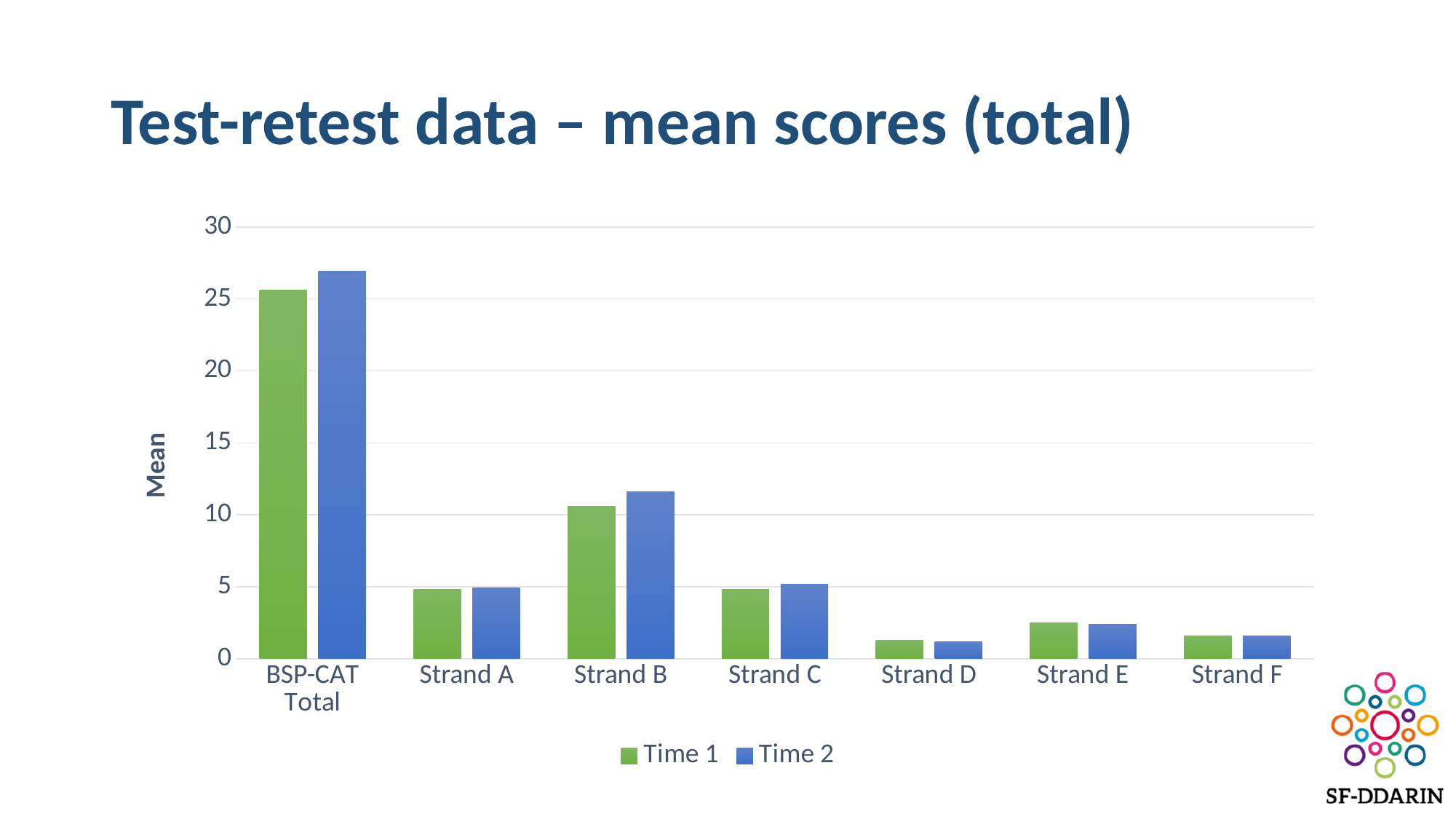
What is the label on the y axis? Mean Is the Time 2 value for Strand B greater or less than 10? greater How many series does the legend list? 2 For Strand B, which is larger, the Time 1 value or the Time 2 value? Time 2 Which category has the highest Time 1 value? BSP-CAT Total Which has the larger Time 1 value, Strand B or Strand C? Strand B Is the Time 1 value for Strand E greater or less than 5? less Which category has the highest Time 2 value? BSP-CAT Total How many categories are shown on the x axis? 7 What kind of chart is shown on the slide? bar chart Is the Time 2 value for BSP-CAT Total greater or less than 25? greater For BSP-CAT Total, which is larger, the Time 1 value or the Time 2 value? Time 2